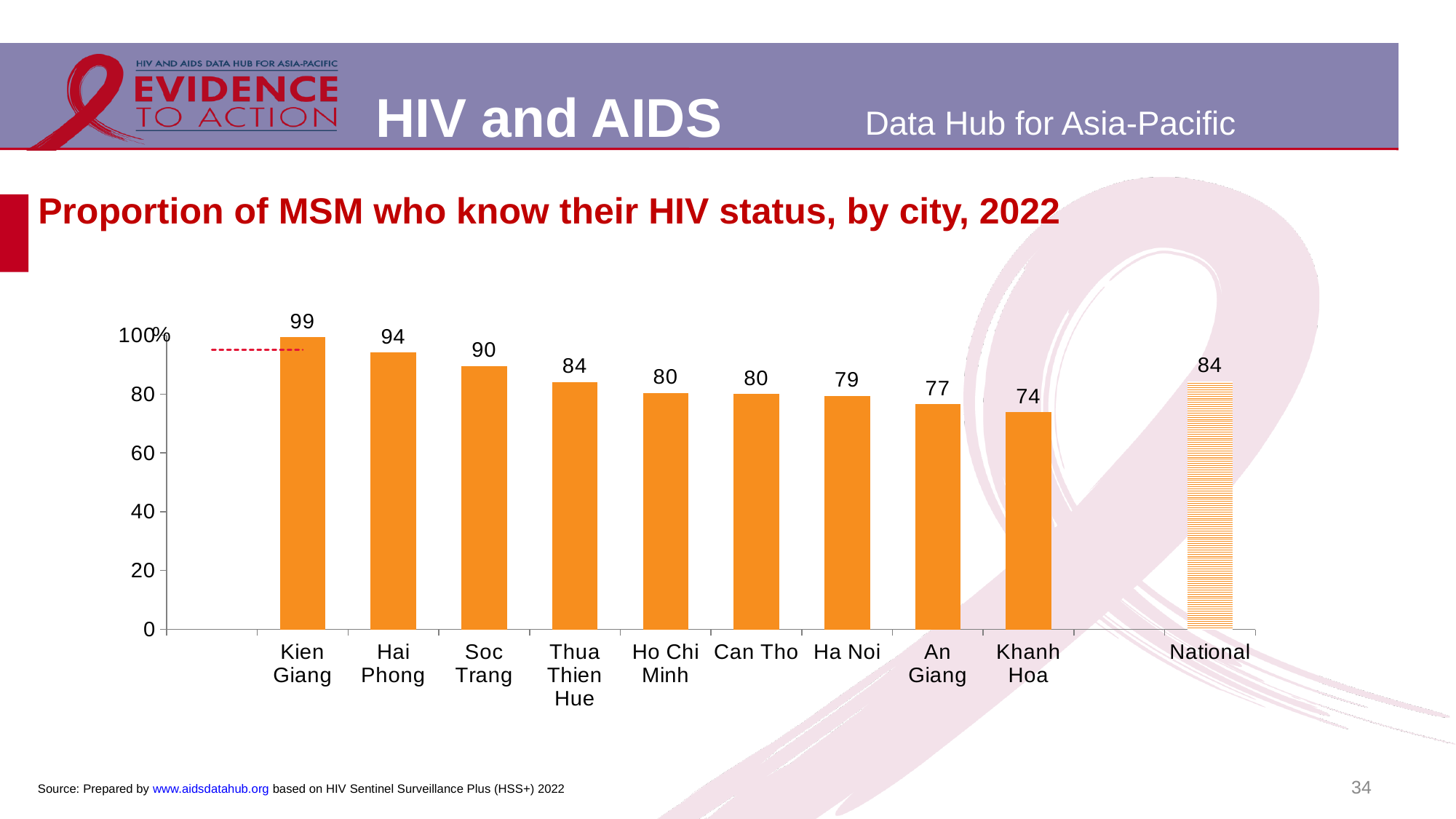
What is the value for Kien Giang? 99 What kind of chart is shown on the slide? Bar chart Which is larger, the value for Hai Phong or the value for Soc Trang? Hai Phong What is the National value? 84 Is the value for An Giang greater or less than 80? less Do the city values rise or fall from Kien Giang to Khanh Hoa along the x axis? Fall How many bars are plotted on the chart, including National? 10 What is the difference between the values for Kien Giang and Khanh Hoa? 25 Which city has the highest proportion of MSM who know their HIV status? Kien Giang What is the title of the chart? Proportion of MSM who know their HIV status, by city, 2022 Which city has the lowest proportion of MSM who know their HIV status? Khanh Hoa What is the value for Khanh Hoa? 74